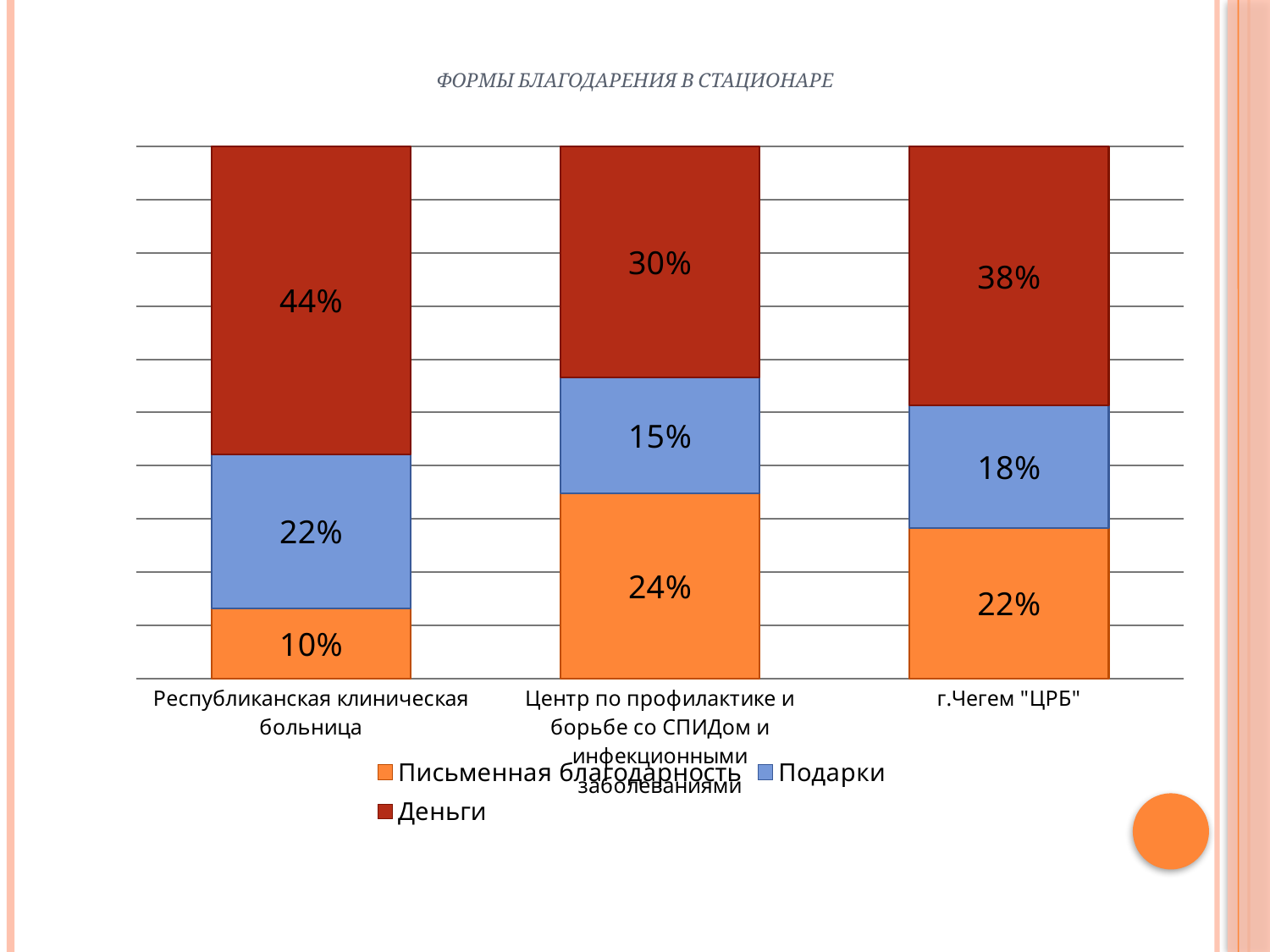
How many categories are shown on the x axis? 3 Which category has the lowest value for Подарки? Центр по профилактике и борьбе со СПИДом и инфекционными заболеваниями Which category has the highest value for Деньги? Республиканская клиническая больница Which category has the lowest value for Письменная благодарность? Республиканская клиническая больница What kind of chart is shown on the slide? Stacked bar chart What is the value for Письменная благодарность at Республиканская клиническая больница? 10% How many series does the legend list? 3 What is the value for Письменная благодарность at Центр по профилактике и борьбе со СПИДом и инфекционными заболеваниями? 24% Which is larger: Подарки at Республиканская клиническая больница or Подарки at г.Чегем "ЦРБ"? Республиканская клиническая больница What is the value for Деньги at Республиканская клиническая больница? 44% What is the value for Подарки at г.Чегем "ЦРБ"? 18% What is the difference between the Деньги values for Республиканская клиническая больница and г.Чегем "ЦРБ"? 6%